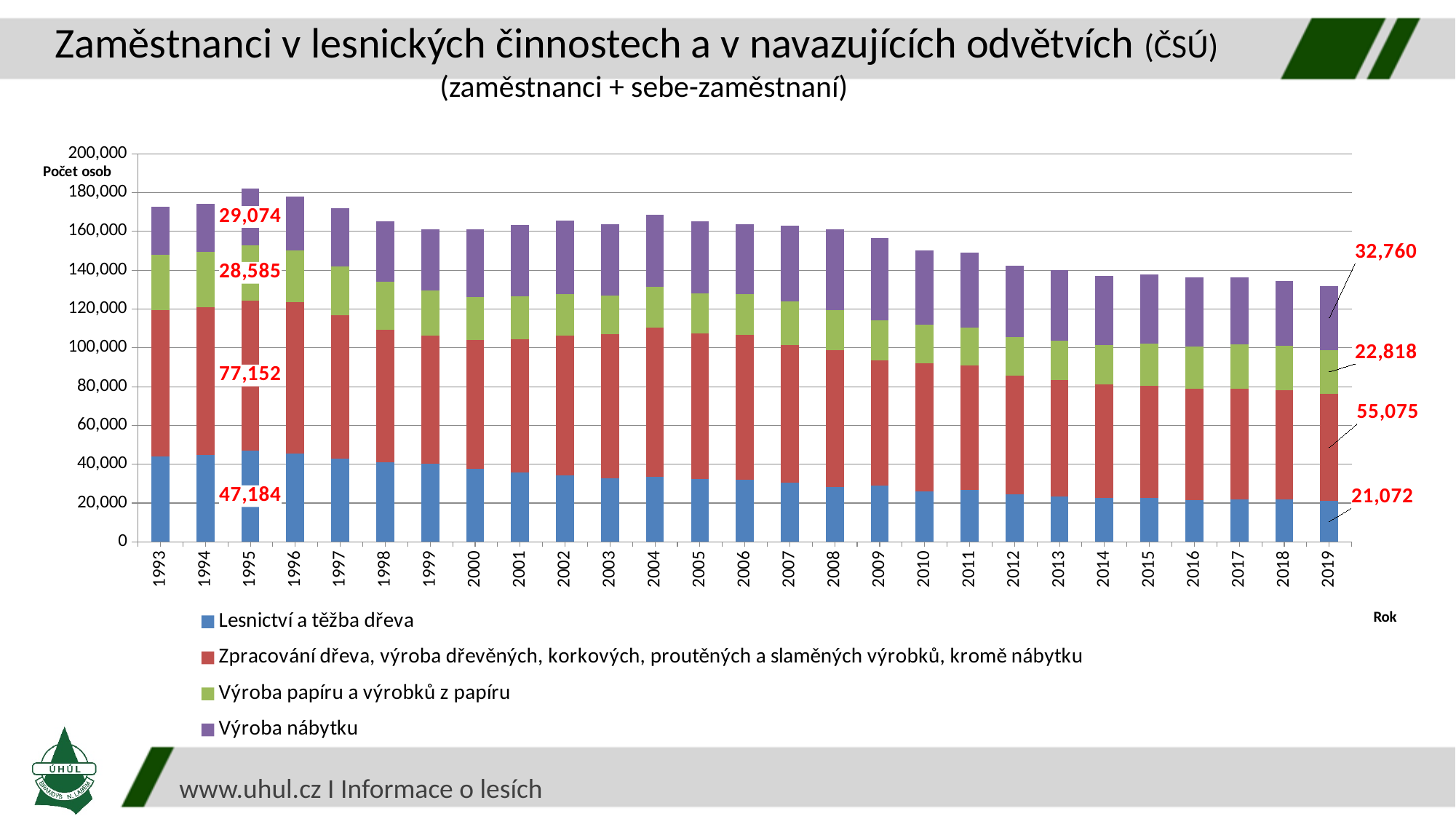
In 2019, which is larger: Výroba nábytku or Výroba papíru a výrobků z papíru? Výroba nábytku What is the value for Lesnictví a těžba dřeva in 2019? 21,072 What is the total of the stacked bar for 1995? 181,995 What is the value for Zpracování dřeva, výroba dřevěných, korkových, proutěných a slaměných výrobků, kromě nábytku in 2019? 55,075 What is the value for Výroba nábytku in 1995? 29,074 Which year has the highest total stacked bar? 1995 How many years are shown on the x axis? 27 What is the total of the stacked bar for 2019? 131,725 By how much did the value for Lesnictví a těžba dřeva fall between 1995 and 2019? 26,112 What is the value for Výroba papíru a výrobků z papíru in 1995? 28,585 How many series does the legend list? 4 What kind of chart is shown on the slide? Stacked bar chart